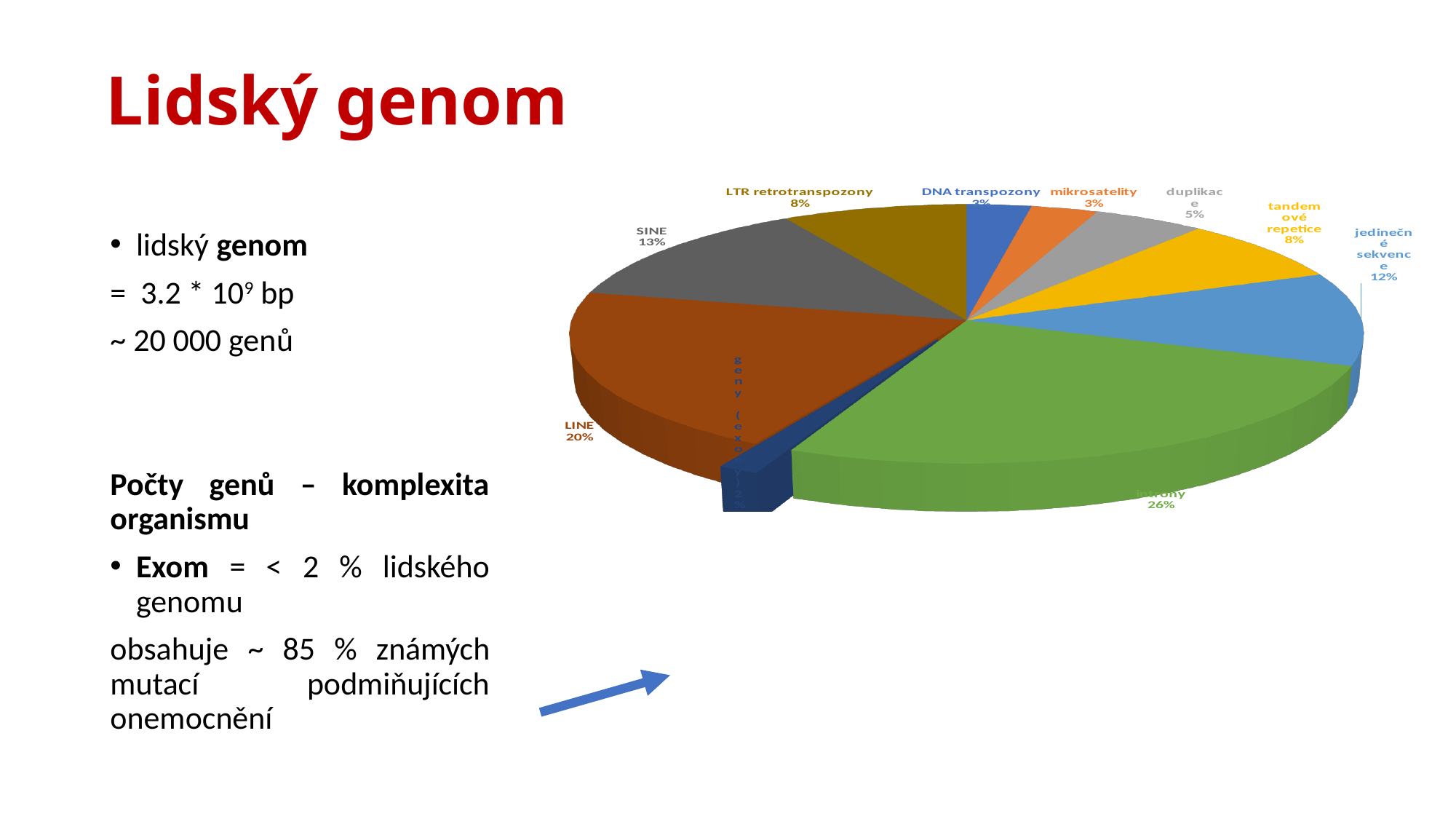
What kind of chart is shown on the slide? pie chart What percentage is shown for tandemové repetice? 8% Which is larger, the LINE slice or the SINE slice? LINE Which slice of the pie is the largest? introny What is the difference in percentage points between introny and LINE? 6% What percentage is shown for jedinečné sekvence? 12% How many slices does the pie chart have? 10 What percentage is shown for SINE? 13% What percentage is shown for mikrosatelity? 3% What share of the pie is labelled for introny? 26% What percentage is shown for LINE? 20% What percentage is shown for duplikace? 5%